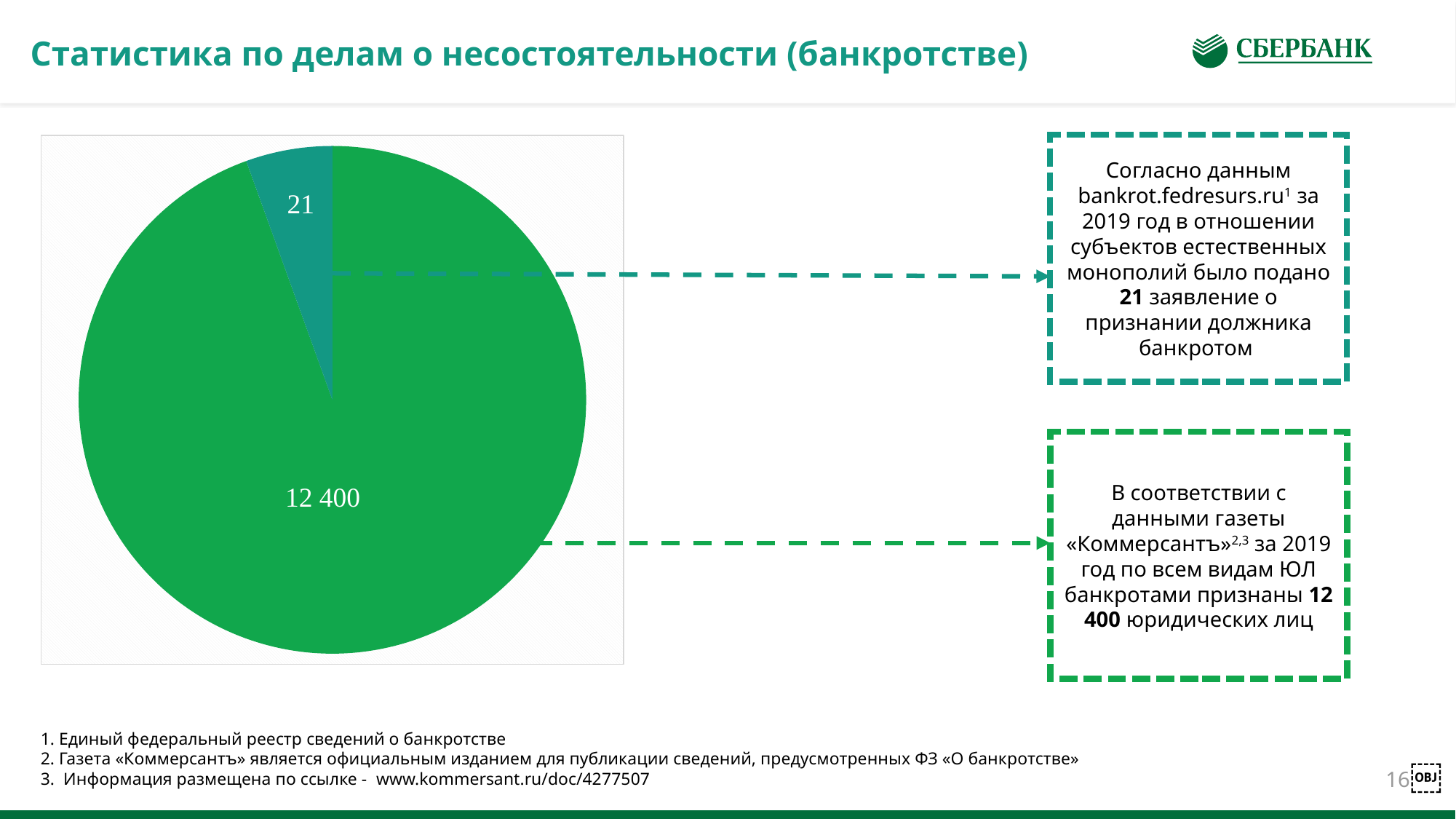
What value is printed on the larger slice of the pie chart? 12 400 What is the value of the slice linked by the dashed arrow to the text about legal entities declared bankrupt according to «Коммерсантъ»? 12 400 What is the largest value shown in the pie chart? 12 400 What is the value of the slice linked by the dashed arrow to the text about bankruptcy applications against natural monopoly subjects (субъектов естественных монополий)? 21 Does the pie chart have a legend? No What is the sum of the two values shown in the pie chart? 12 421 What is the difference between the two values shown in the pie chart? 12 379 What kind of chart is shown on the slide? pie chart Which slice is larger: the one labelled 21 or the one labelled 12 400? 12 400 What is the smallest value shown in the pie chart? 21 What value is printed on the smaller slice of the pie chart? 21 How many slices does the pie chart have? 2